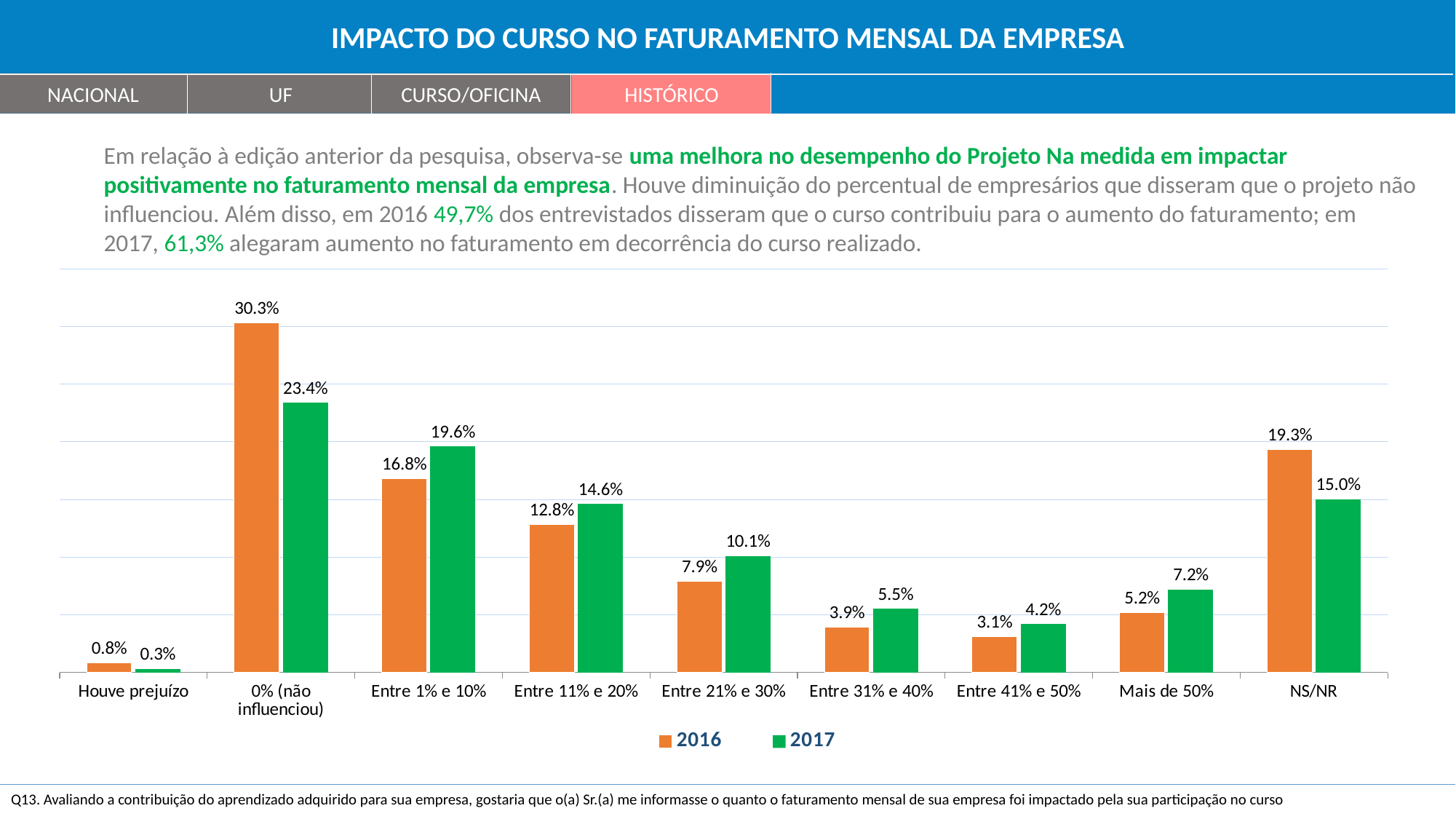
Which colour represents the 2017 series in the chart? Green For "Mais de 50%", which year has the larger value, 2016 or 2017? 2017 What is the 2017 value for "Entre 1% e 10%"? 19.6% Which category has the highest 2017 value? 0% (não influenciou) What is the 2017 value for NS/NR? 15.0% What kind of chart is shown on the slide? Bar chart Which category has the lowest 2016 value? Houve prejuízo How many categories are shown on the x axis? 9 What is the difference between the 2017 and 2016 values for "Entre 21% e 30%"? 2.2% What is the 2016 value for "0% (não influenciou)"? 30.3% How many series does the legend list? 2 What is the difference between the 2016 and 2017 values for "0% (não influenciou)"? 6.9%